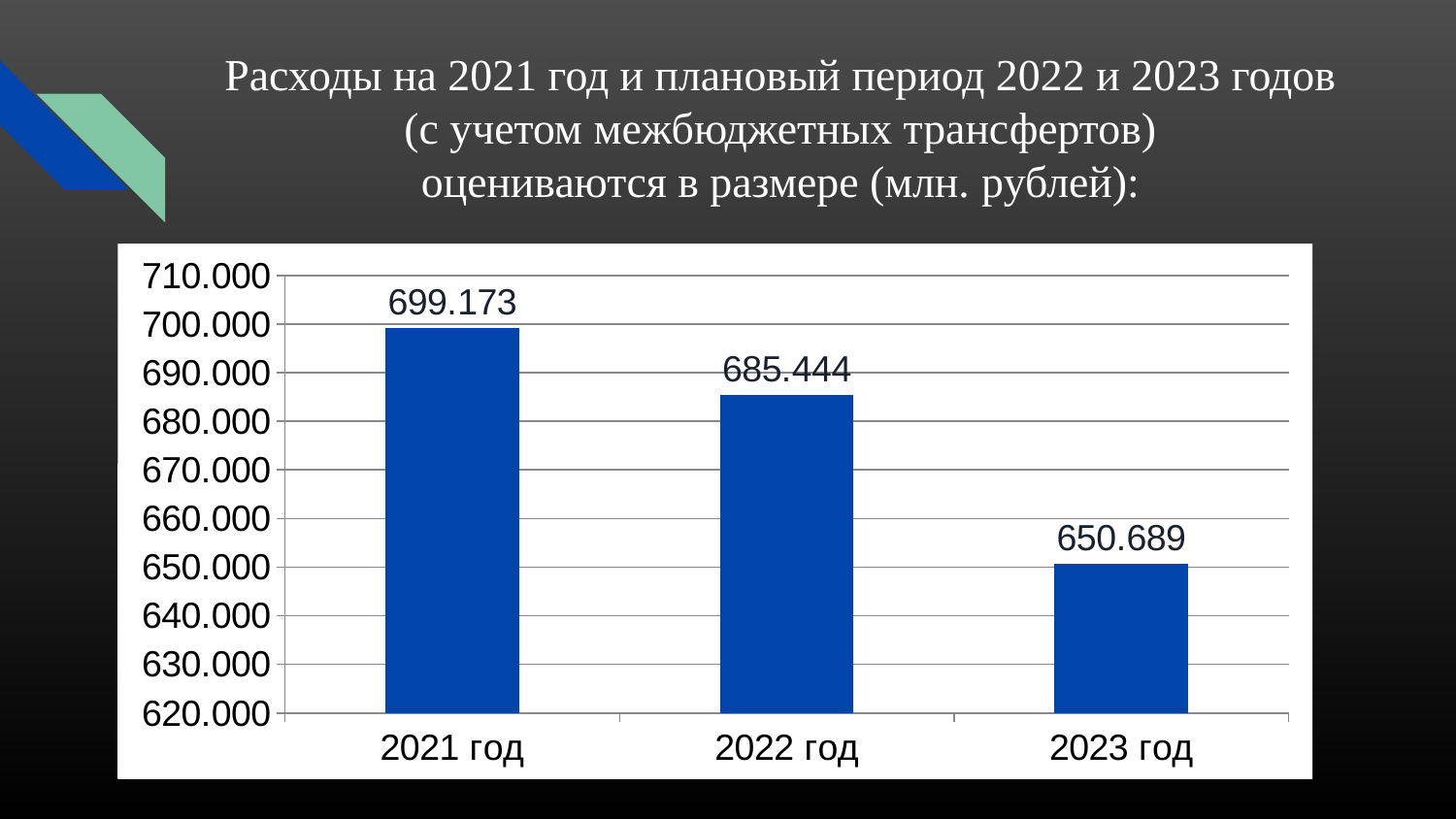
What is the value for 2023 год? 650.689 What is the difference between the values for 2021 год and 2023 год? 48.484 How many years are shown in the chart? 3 What kind of chart is shown on the slide? bar chart What is the difference between the values for 2021 год and 2022 год? 13.729 What is the value for 2022 год? 685.444 What is the difference between the values for 2022 год and 2023 год? 34.755 Which is larger, the value for 2022 год or the value for 2023 год? 2022 год Is the value for 2023 год greater or less than 660.000? less What is the value for 2021 год? 699.173 Which year has the highest value? 2021 год Which year has the lowest value? 2023 год